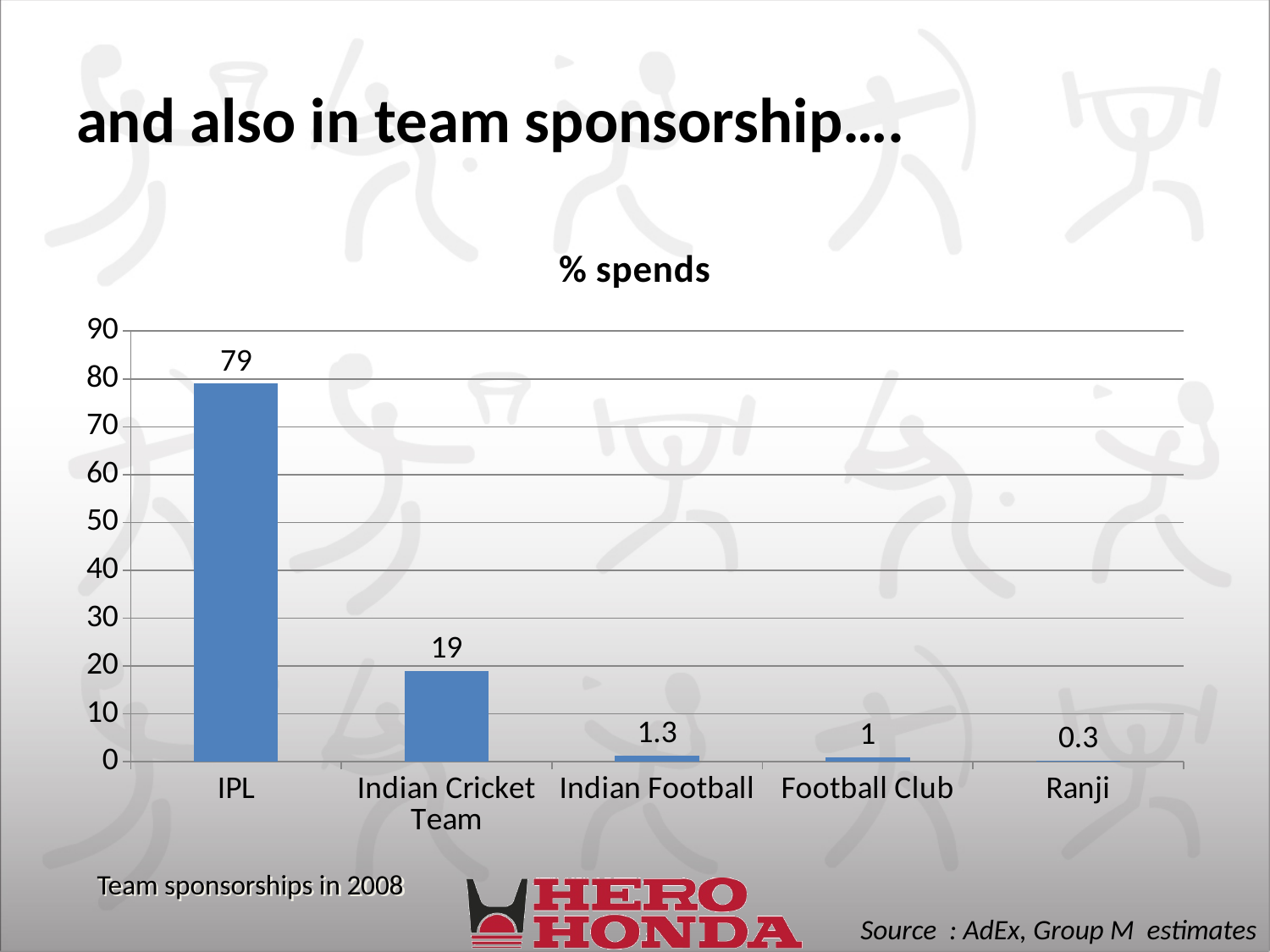
What is the value for Indian Cricket Team? 19 What kind of chart is shown on the slide? bar chart Which is larger, the value for Indian Football or the value for Football Club? Indian Football Is the value for Indian Cricket Team greater or less than 20? less Which category has the highest value? IPL What is the title of the chart? % spends Which category has the lowest value? Ranji What is the value for Indian Football? 1.3 How many categories are shown on the x axis? 5 What is the value for IPL? 79 What is the difference between the values for IPL and Indian Cricket Team? 60 What is the value for Ranji? 0.3